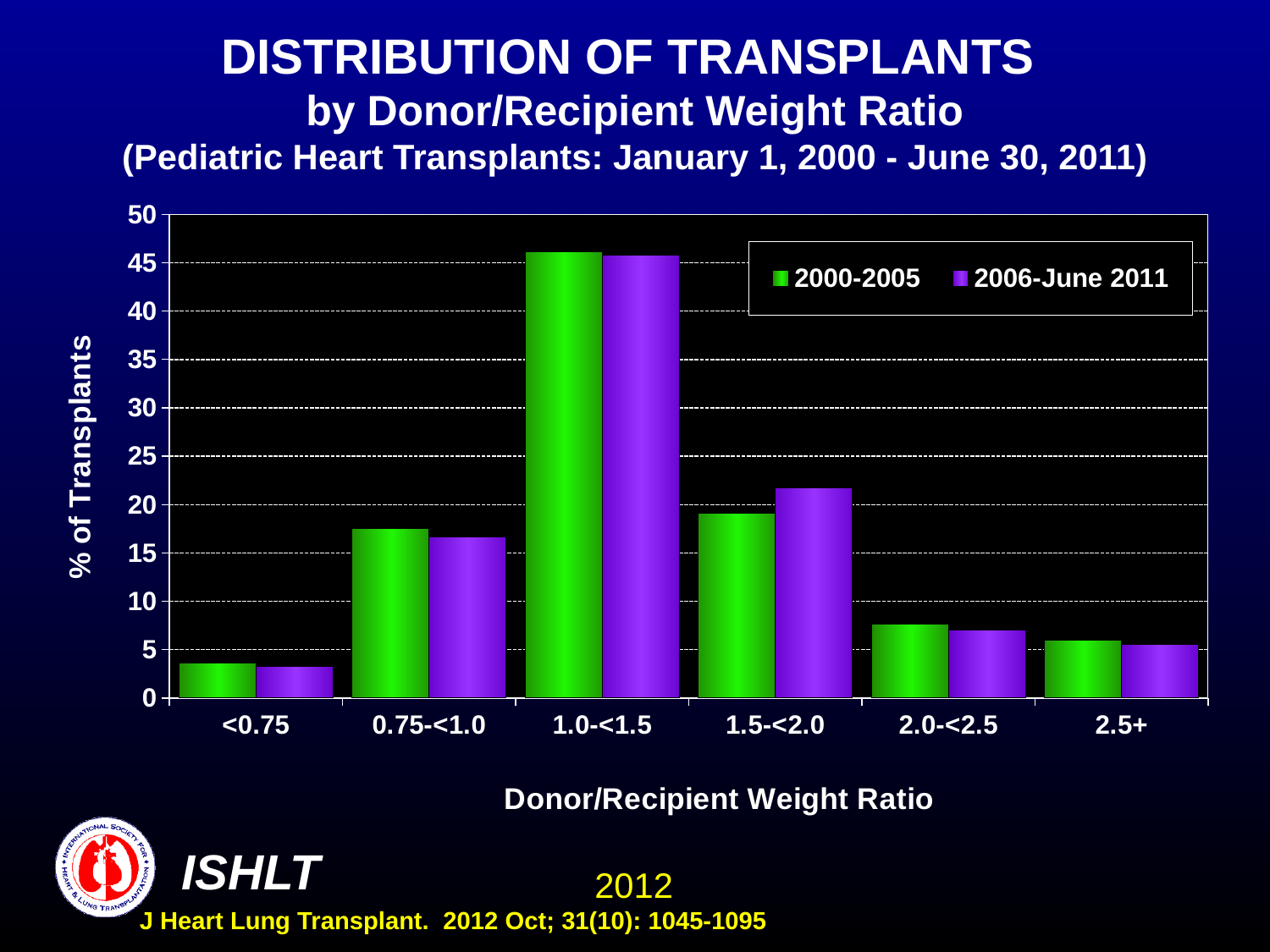
Which weight ratio category has the lowest percentage of transplants for 2006-June 2011? <0.75 Is the value for <0.75 in 2000-2005 greater or less than 5? less Is the value for 1.5-<2.0 in 2006-June 2011 greater or less than 20? greater Is the value for 1.0-<1.5 in 2000-2005 greater or less than 45? greater What type of chart is shown on the slide? bar chart What is the label of the y axis? % of Transplants For the 1.5-<2.0 category, which period has the larger percentage of transplants, 2000-2005 or 2006-June 2011? 2006-June 2011 How many series does the legend list? 2 Which weight ratio category has the highest percentage of transplants for 2000-2005? 1.0-<1.5 How many donor/recipient weight ratio categories are shown on the x axis? 6 For the 0.75-<1.0 category, which period has the larger percentage of transplants, 2000-2005 or 2006-June 2011? 2000-2005